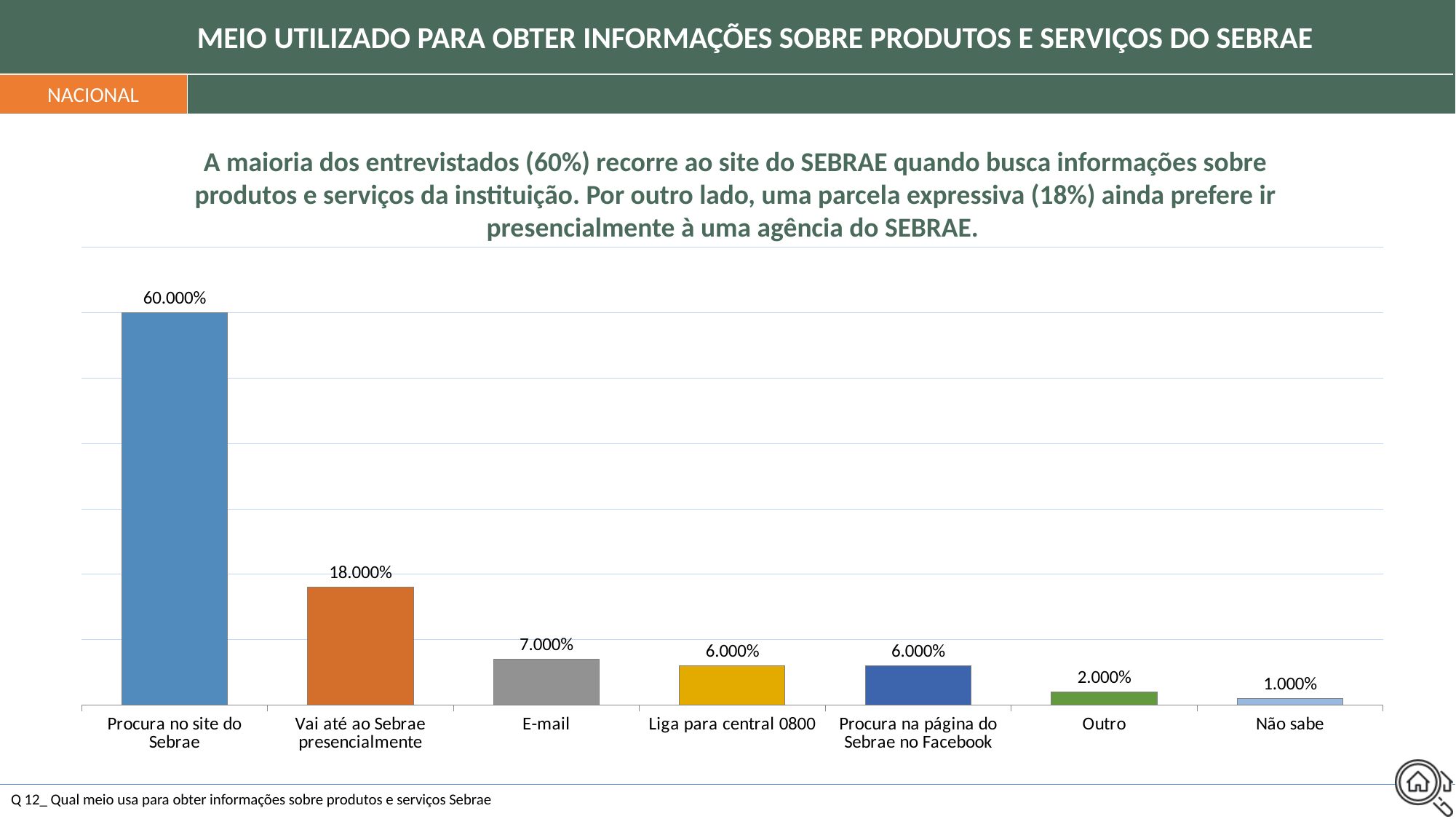
How many categories are shown on the x axis? 7 What is the value for "E-mail"? 7.000% Which category has the highest value? Procura no site do Sebrae What is the value for "Não sabe"? 1.000% Which is larger, the value for "E-mail" or the value for "Outro"? E-mail What kind of chart is shown on the slide? Bar chart Which category has the lowest value? Não sabe What is the value for "Liga para central 0800"? 6.000% What is the value for "Vai até ao Sebrae presencialmente"? 18.000% What is the difference between the values for "Procura no site do Sebrae" and "Vai até ao Sebrae presencialmente"? 42.000% What is the difference between the values for "E-mail" and "Outro"? 5.000% What is the value for "Procura no site do Sebrae"? 60.000%